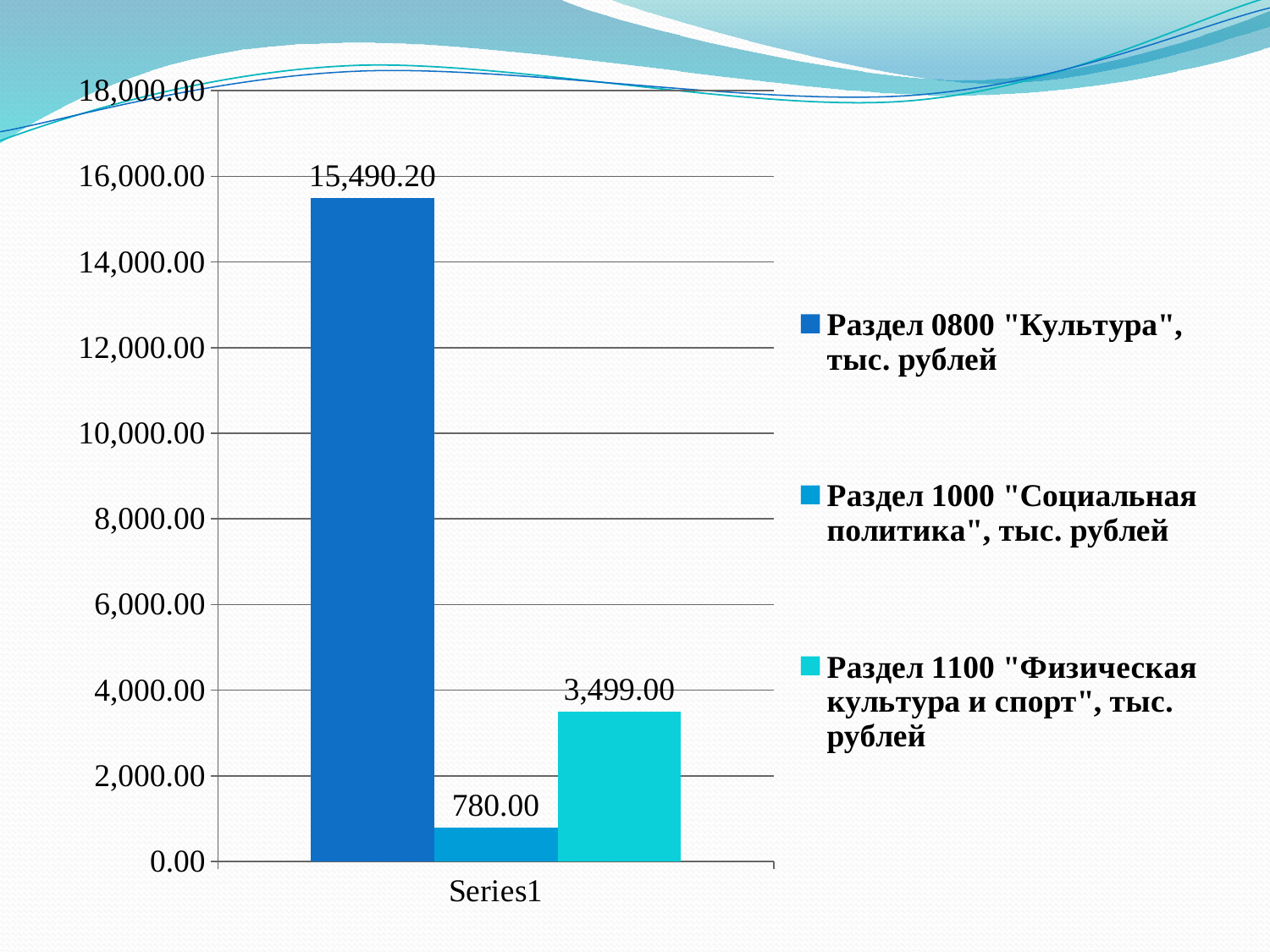
How many series does the legend list? 3 What is the category label shown on the x axis? Series1 Which series has the lowest value? Раздел 1000 "Социальная политика", тыс. рублей What is the value for Раздел 1100 "Физическая культура и спорт"? 3,499.00 Which is larger: the value for Раздел 1100 "Физическая культура и спорт" or the value for Раздел 1000 "Социальная политика"? Раздел 1100 "Физическая культура и спорт" What type of chart is shown on the slide? bar chart Is the value for Раздел 0800 "Культура" greater or less than 14,000.00? greater What is the value for Раздел 0800 "Культура"? 15,490.20 What is the difference between the values for Раздел 1100 "Физическая культура и спорт" and Раздел 1000 "Социальная политика"? 2,719.00 Which series has the highest value? Раздел 0800 "Культура", тыс. рублей What is the value for Раздел 1000 "Социальная политика"? 780.00 What is the difference between the values for Раздел 0800 "Культура" and Раздел 1100 "Физическая культура и спорт"? 11,991.20